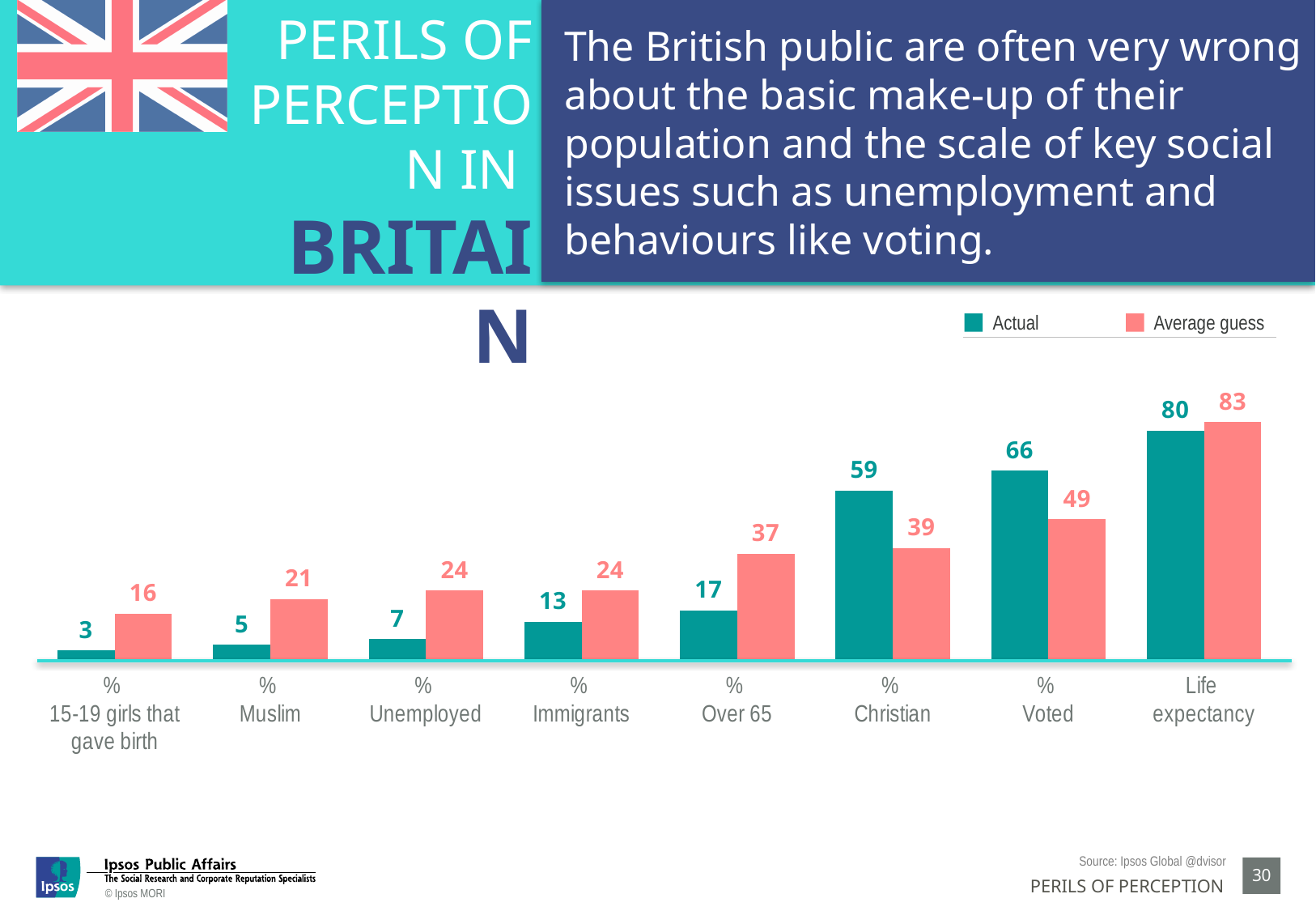
What is the Actual value for % Christian? 59 What is the difference between the Average guess and the Actual value for % Over 65? 20 Which category has the lowest Actual value? % 15-19 girls that gave birth What colour are the Average guess bars? Pink Do the Actual values rise or fall from left to right along the x axis? Rise What is the Actual value for % Muslim? 5 Which category has the highest Average guess value? Life expectancy For % Voted, which is larger, the Actual value or the Average guess? Actual How many categories are shown on the x axis? 8 What kind of chart is shown on the slide? Bar chart What is the Average guess value for % Unemployed? 24 How many series does the legend list? 2